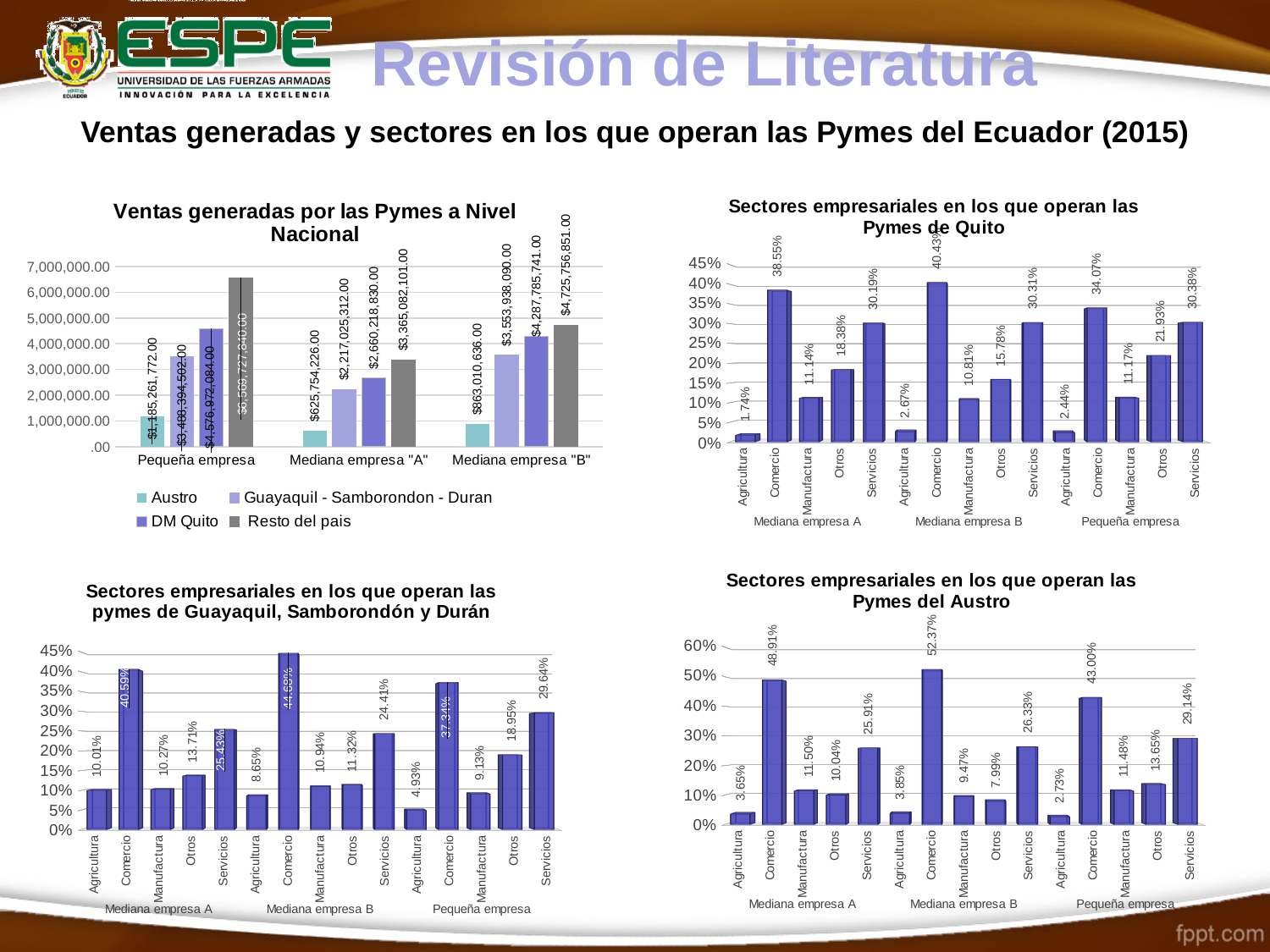
In the chart 'Sectores empresariales en los que operan las Pymes de Quito', what is the difference between Servicios and Otros in Pequeña empresa? 8.45% In the chart 'Ventas generadas por las Pymes a Nivel Nacional', how many series does the legend list? 4 In the chart 'Ventas generadas por las Pymes a Nivel Nacional', is the value for Resto del pais in Mediana empresa "A" greater or less than 3,000,000.00? greater In the chart 'Ventas generadas por las Pymes a Nivel Nacional', what is the value for Austro in Mediana empresa "A"? $625,754,226.00 In the chart 'Sectores empresariales en los que operan las Pymes del Austro', what is the value for Comercio in Mediana empresa B? 52.37% In the chart 'Sectores empresariales en los que operan las Pymes de Quito', which sector has the lowest value in Mediana empresa A? Agricultura In the chart 'Sectores empresariales en los que operan las Pymes de Quito', what is the value for Comercio in Mediana empresa B? 40.43% In the chart 'Sectores empresariales en los que operan las pymes de Guayaquil, Samborondón y Durán', what is the value for Servicios in Pequeña empresa? 29.64% What type of chart is 'Sectores empresariales en los que operan las Pymes del Austro'? Bar chart In the chart 'Ventas generadas por las Pymes a Nivel Nacional', what is the value for DM Quito in Mediana empresa "B"? $4,287,785,741.00 In the chart 'Ventas generadas por las Pymes a Nivel Nacional', which series has the lowest value for Pequeña empresa? Austro In the chart 'Sectores empresariales en los que operan las pymes de Guayaquil, Samborondón y Durán', which is larger in Mediana empresa A: Otros or Manufactura? Otros